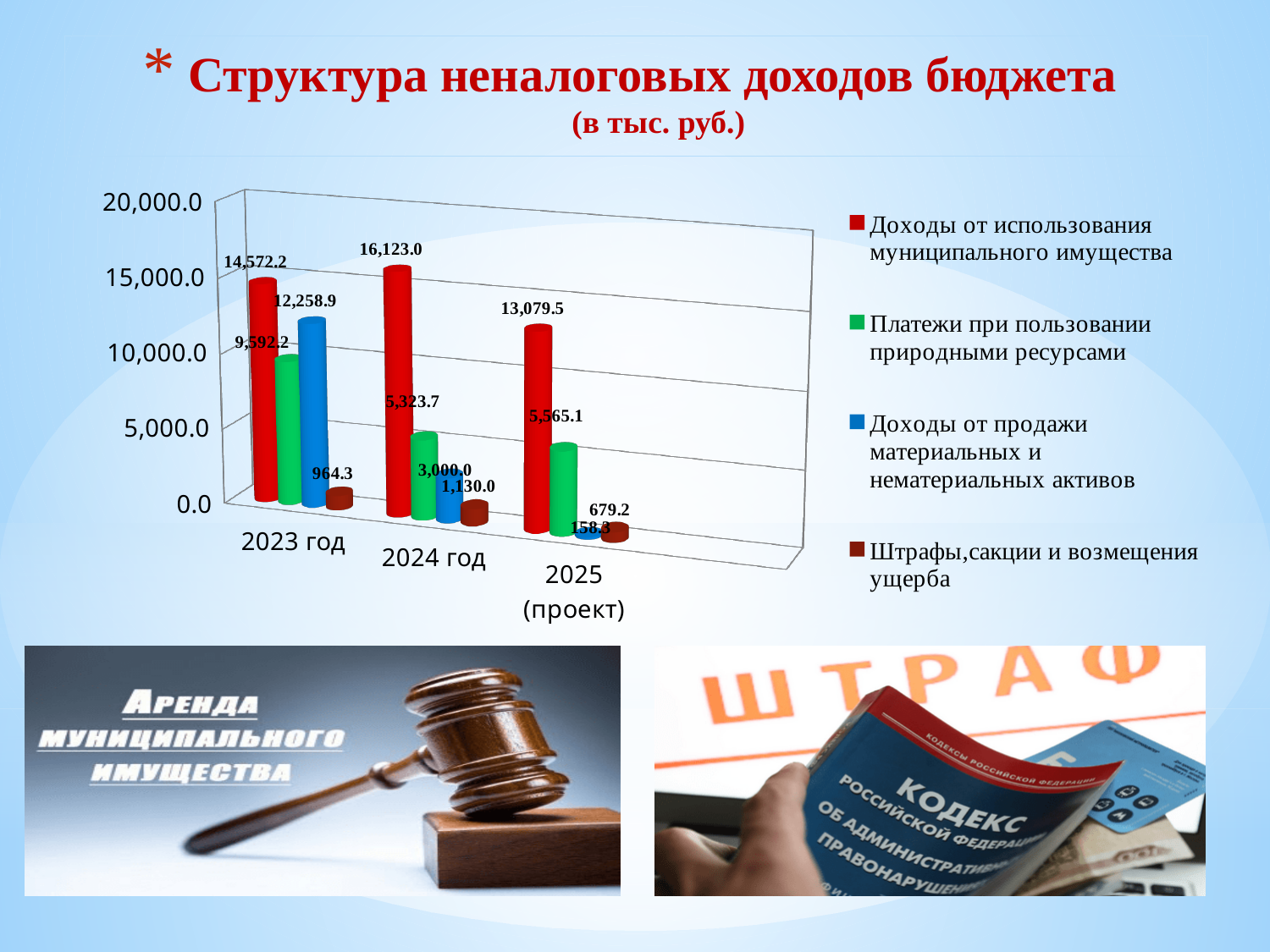
What is the value of 'Платежи при пользовании природными ресурсами' for 2023 год? 9,592.2 What is the value of 'Штрафы,сакции и возмещения ущерба' for 2024 год? 1,130.0 What is the value of 'Доходы от продажи материальных и нематериальных активов' for 2025 (проект)? 158.3 In which year is 'Доходы от использования муниципального имущества' highest? 2024 год Which colour represents 'Штрафы,сакции и возмещения ущерба' in the legend? Brown Which is larger in 2023 год: 'Платежи при пользовании природными ресурсами' or 'Доходы от продажи материальных и нематериальных активов'? Доходы от продажи материальных и нематериальных активов What type of chart is shown on the slide? Bar chart In which year is 'Доходы от продажи материальных и нематериальных активов' lowest? 2025 (проект) How many series does the legend list? 4 What is the value of 'Доходы от использования муниципального имущества' for 2024 год? 16,123.0 What is the difference between 'Доходы от использования муниципального имущества' in 2024 год and in 2025 (проект)? 3,043.5 How many year categories are shown on the x axis? 3